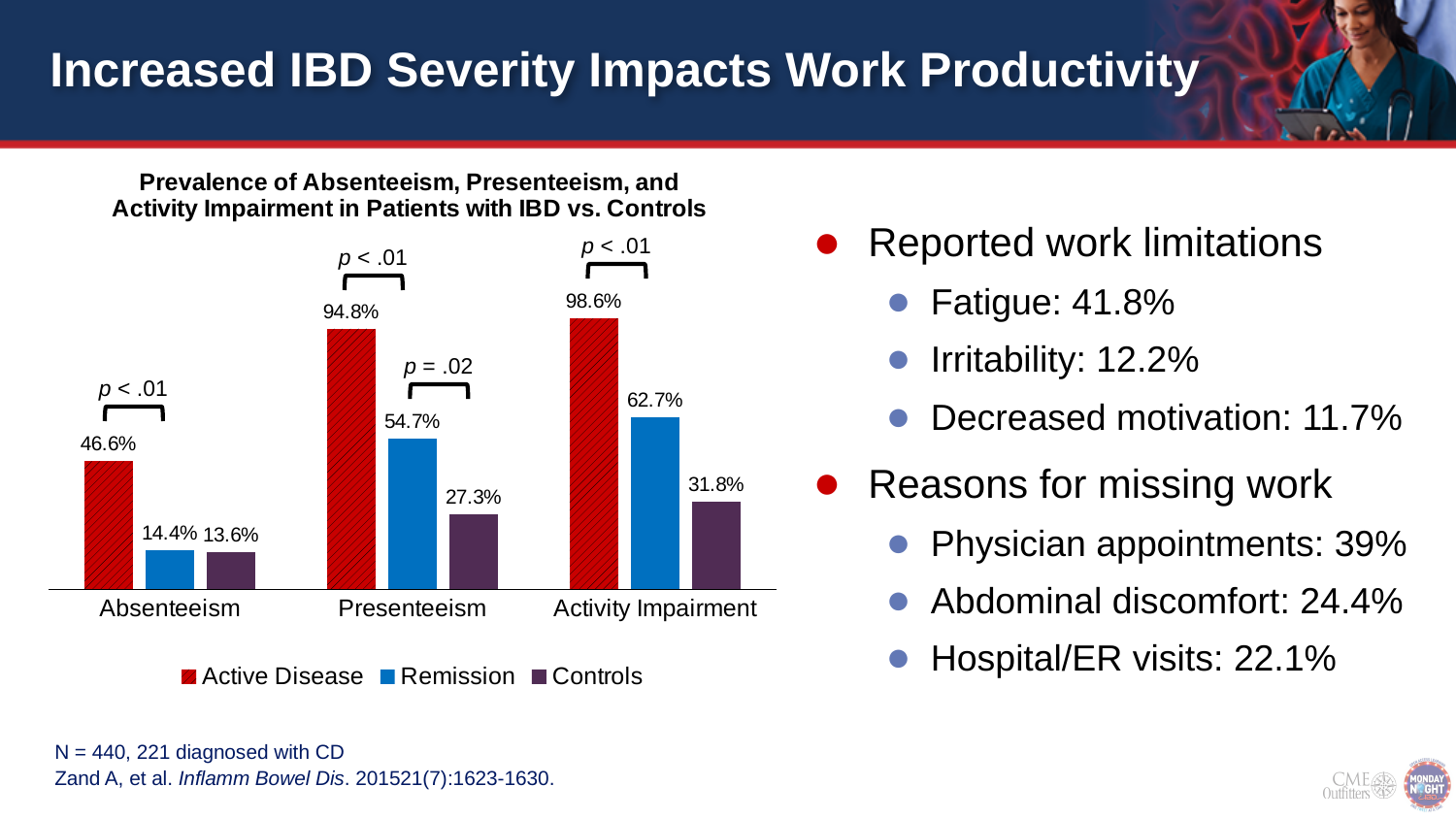
What p value is shown above the Presenteeism Remission vs. Controls comparison? p = .02 How many categories are shown on the x axis? 3 Which category has the lowest Controls value? Absenteeism How many series does the legend list? 3 Which category has the highest Active Disease value? Activity Impairment What is the Remission value for Absenteeism? 14.4% What is the Remission value for Activity Impairment? 62.7% What is the Active Disease value for Presenteeism? 94.8% What is the difference between the Active Disease and Remission values for Presenteeism? 40.1% What is the Controls value for Absenteeism? 13.6% What kind of chart is shown on the slide? Bar chart Which is larger for Activity Impairment: the Remission value or the Controls value? Remission